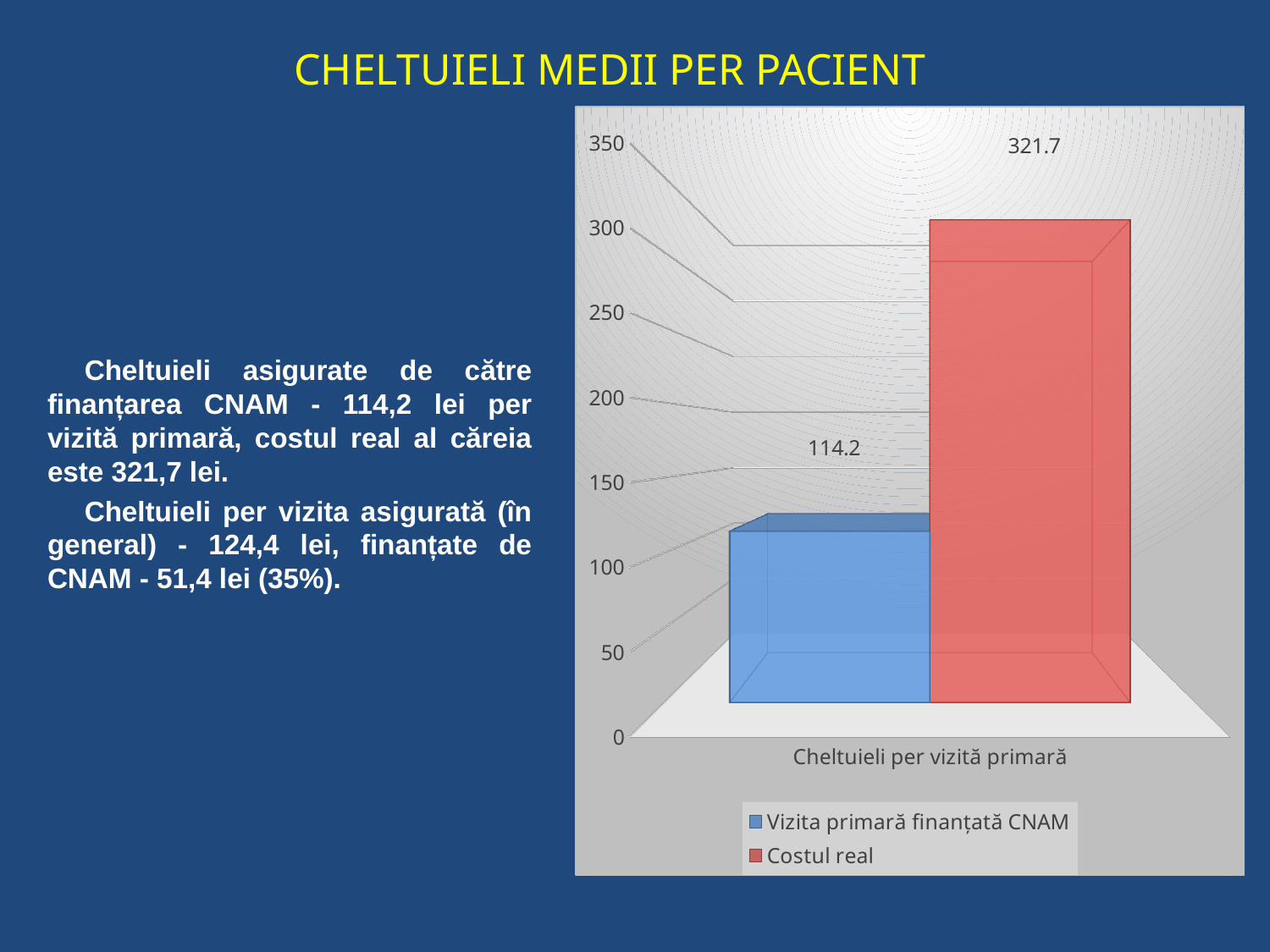
Which series has the higher value, 'Vizita primară finanțată CNAM' or 'Costul real'? Costul real How many series does the legend list? 2 What is the difference between the 'Costul real' value and the 'Vizita primară finanțată CNAM' value? 207.5 What is the value for 'Vizita primară finanțată CNAM' in the chart? 114.2 Is the value for 'Costul real' greater or less than 300? greater Which series has the lowest value in the chart? Vizita primară finanțată CNAM What is the value for 'Costul real' in the chart? 321.7 What is the category label shown on the x axis of the chart? Cheltuieli per vizită primară What colour is the bar for 'Costul real'? Red What kind of chart is shown on the slide? Bar chart How many categories are shown on the x axis of the chart? 1 Is the value for 'Vizita primară finanțată CNAM' greater or less than 150? less